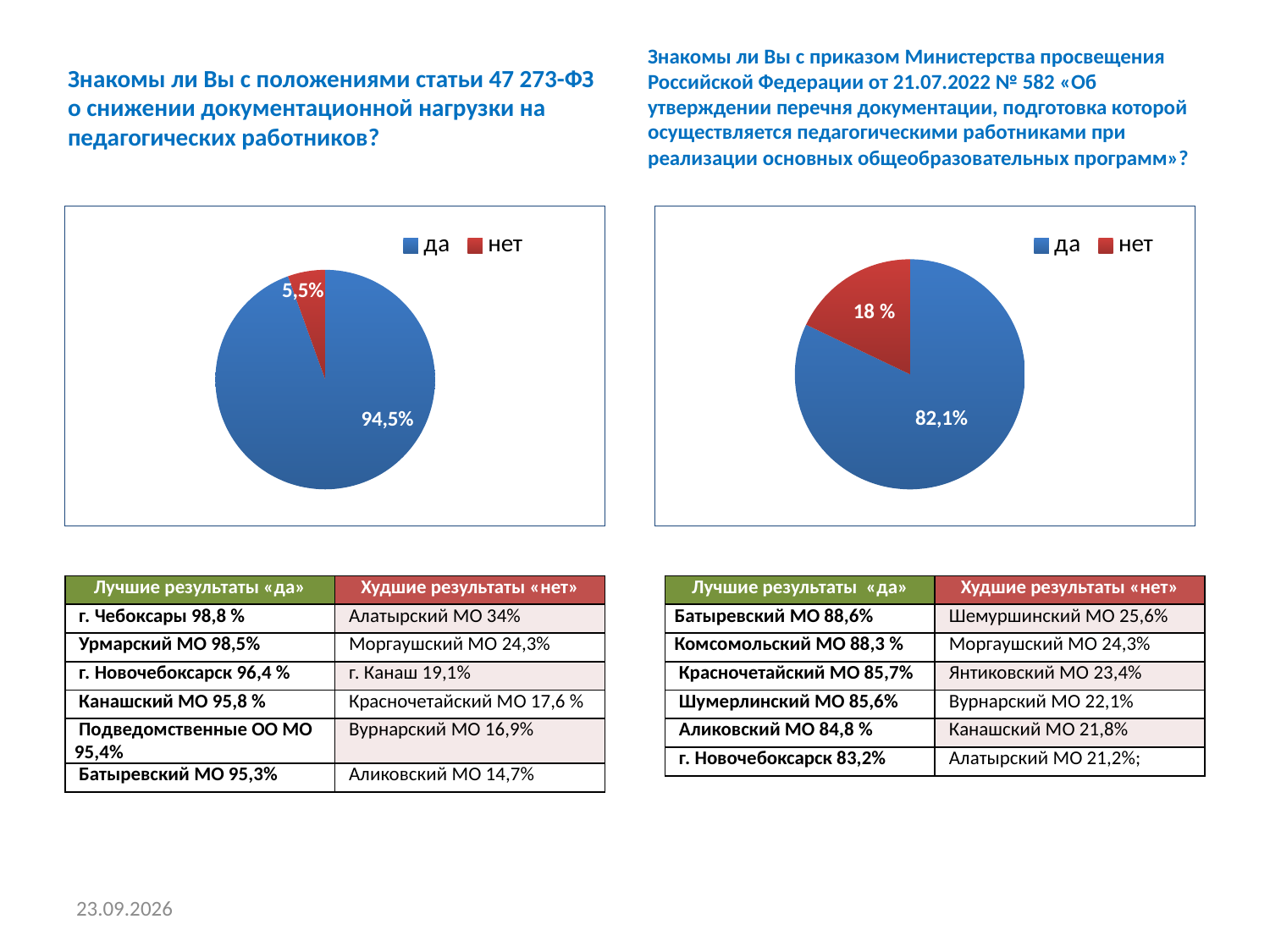
In the right pie chart, what is the value for "да"? 82,1% In the left pie chart, what is the value for "нет"? 5,5% What kind of chart is the right chart? pie chart In the left pie chart, which is larger, "да" or "нет"? да How many entries does the legend of the right pie chart list? 2 In the right pie chart, what colour is the "нет" slice? red In the right pie chart, what is the value for "нет"? 18 % In the left pie chart, what colour is the "да" slice? blue In the left pie chart, what is the value for "да"? 94,5% How many slices does the left pie chart have? 2 In the right pie chart, which slice is the smallest? нет In the left pie chart, which slice is the largest? да